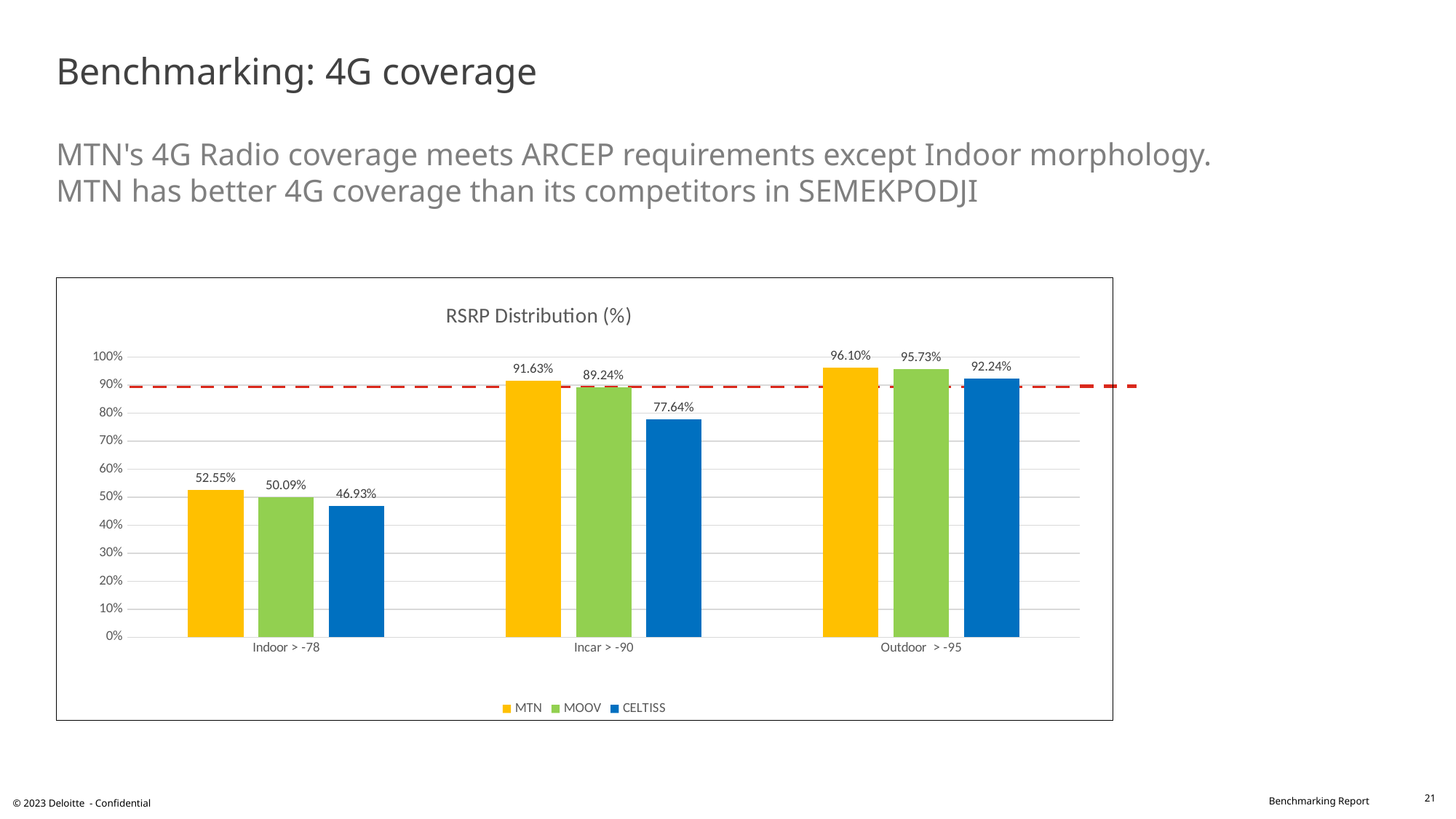
What is the value for MOOV in the Outdoor > -95 category? 95.73% What is the difference between the MTN and CELTISS values in the Incar > -90 category? 13.99% Which series has the lowest value in the Indoor > -78 category? CELTISS Which is larger: the MOOV value for Indoor > -78 or the CELTISS value for Indoor > -78? MOOV value for Indoor > -78 How many categories are shown on the x axis? 3 How many series does the legend list? 3 Which series has the highest value in the Incar > -90 category? MTN What kind of chart is shown on the slide? Bar chart What is the value for CELTISS in the Incar > -90 category? 77.64% What is the value for MTN in the Indoor > -78 category? 52.55% Is the value for CELTISS in the Outdoor > -95 category greater or less than 90%? greater What is the title of the chart? RSRP Distribution (%)